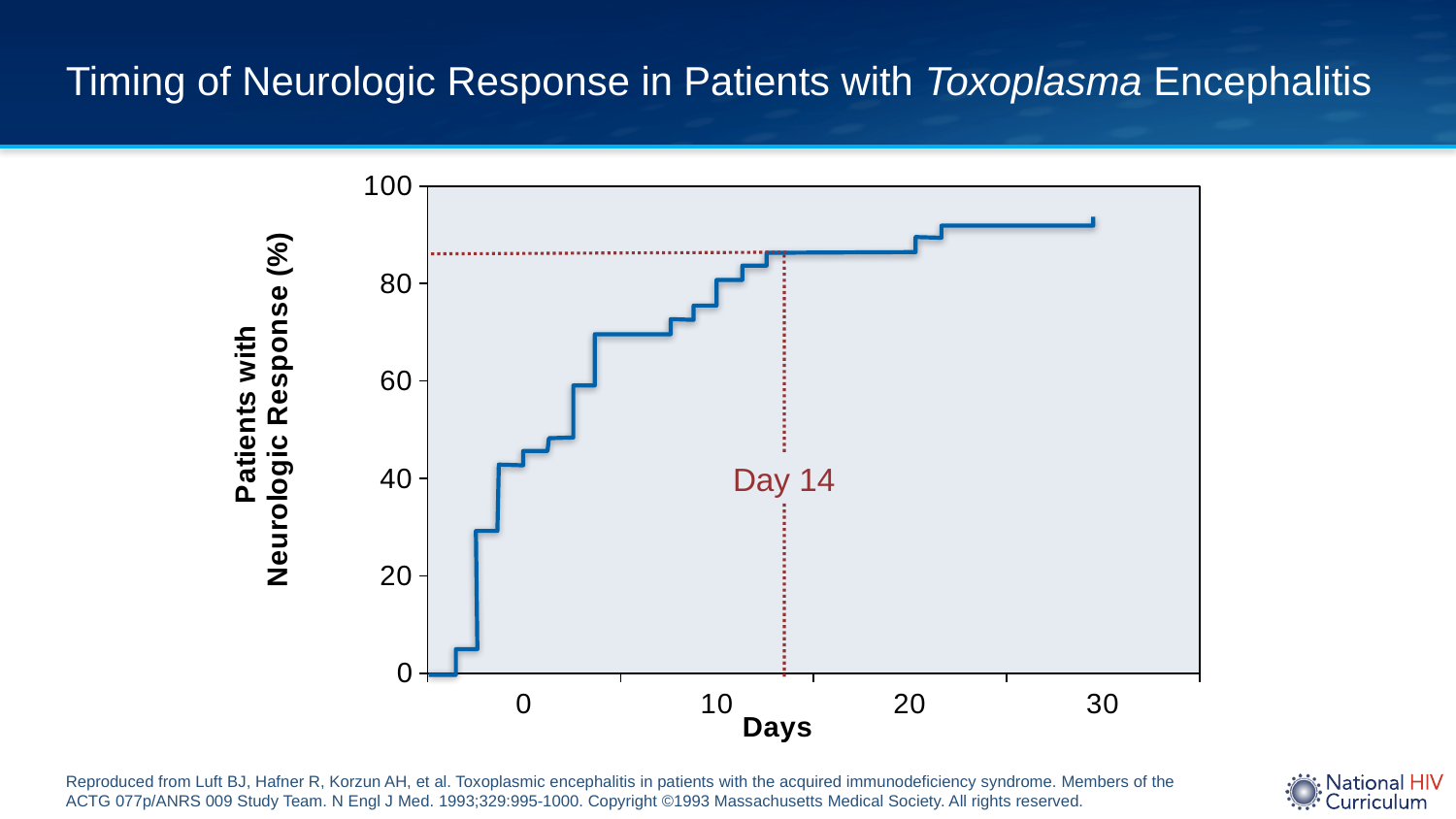
Does the percentage of patients with neurologic response rise or fall as days increase? rise Is the percentage of patients with neurologic response at day 5 greater or less than 60? greater What is the title of the chart on the slide? Timing of Neurologic Response in Patients with Toxoplasma Encephalitis Is the percentage of patients with neurologic response at day 30 greater or less than 80? greater What is the label of the x axis? Days Is the percentage of patients with neurologic response at day 20 greater or less than 80? greater What kind of chart is shown on the slide? line chart Is the percentage of patients with neurologic response at day 14 greater or less than at day 5? greater How many data series are plotted on the chart? 1 Which day is marked by the dotted vertical reference line on the chart? Day 14